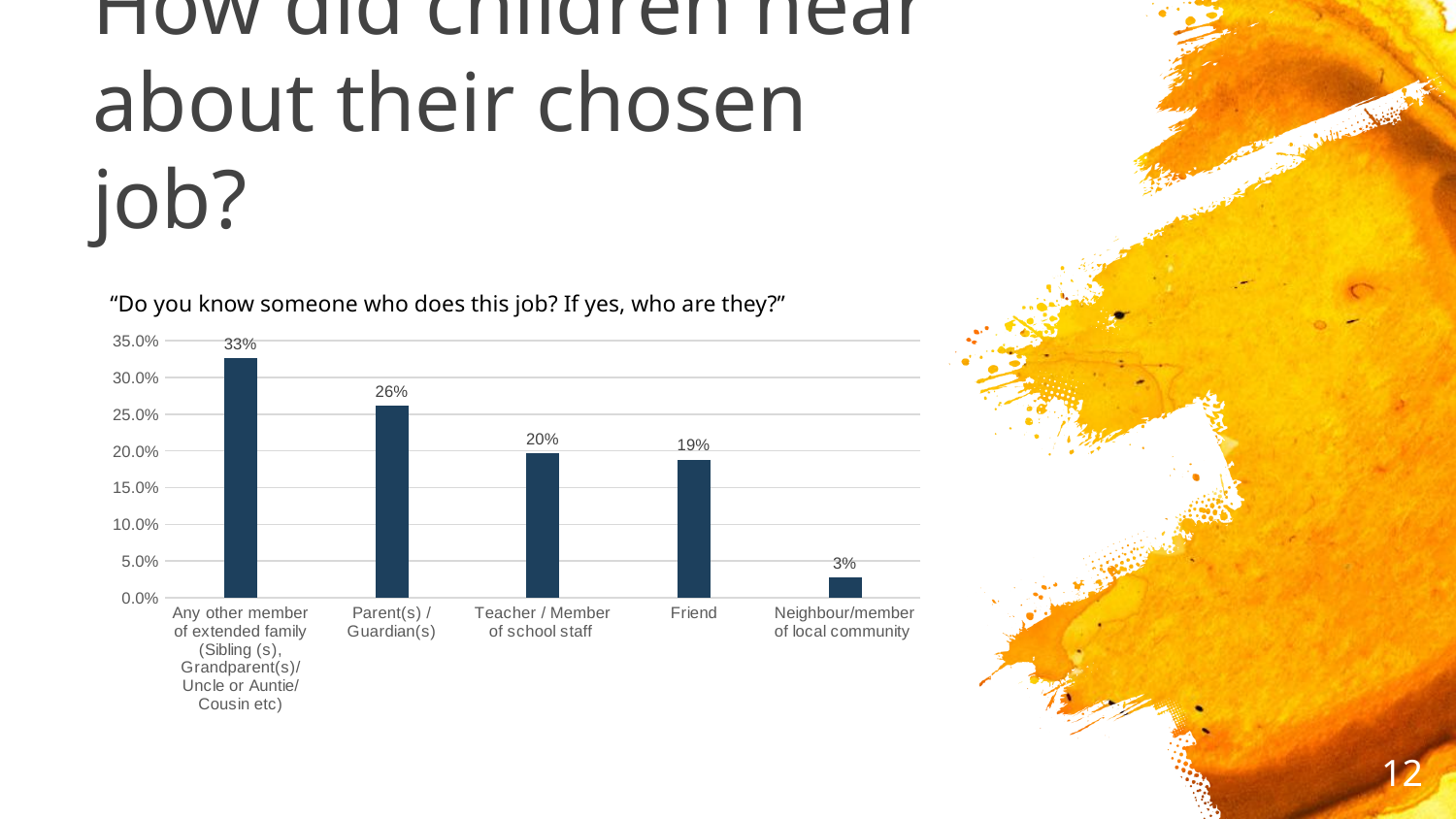
Which category has the lowest value in the chart? Neighbour/member of local community What is the title of the chart? "Do you know someone who does this job? If yes, who are they?" Is the value for Parent(s) / Guardian(s) greater or less than 25.0%? greater What kind of chart is shown on the slide? Bar chart Which is larger: the value for Teacher / Member of school staff or the value for Neighbour/member of local community? Teacher / Member of school staff Which category has the highest value in the chart? Any other member of extended family (Sibling (s), Grandparent(s)/ Uncle or Auntie/ Cousin etc) What is the value for Neighbour/member of local community? 3% What is the difference between the value for Parent(s) / Guardian(s) and the value for Friend? 7% What percentage of children heard about their chosen job from a Parent(s) / Guardian(s)? 26% What is the value for Teacher / Member of school staff? 20% What is the value for Friend in the chart? 19% How many categories are shown in the chart? 5